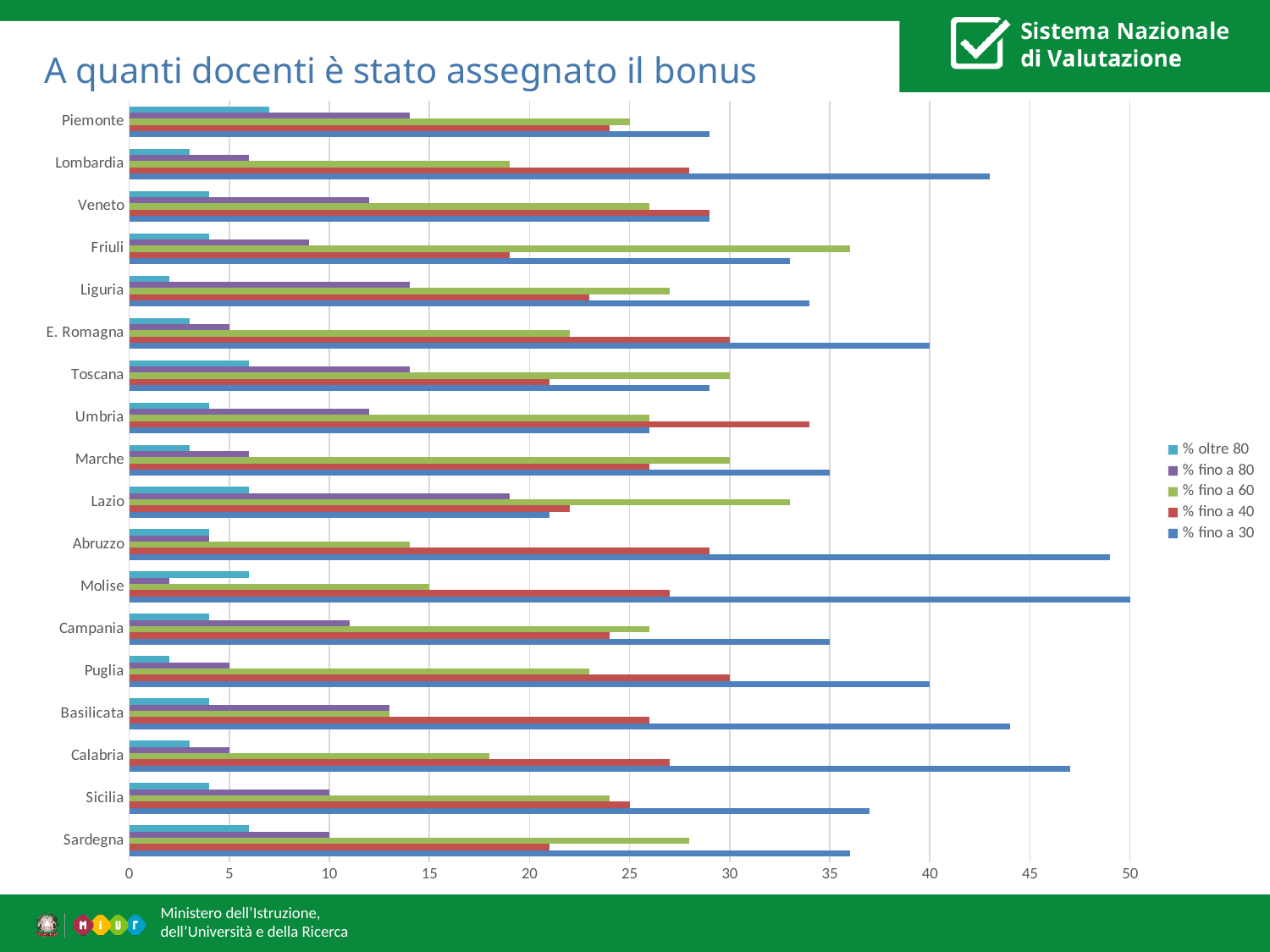
Which legend entry is shown in green? % fino a 60 How many regions are plotted on the chart? 18 Which region has the highest value for '% fino a 60'? Friuli For Umbria, which is larger: '% fino a 40' or '% fino a 30'? % fino a 40 Is the value of '% fino a 30' for Lombardia greater or less than 40? greater How many series does the legend list? 5 Is the value of '% fino a 40' for Umbria greater or less than 30? greater Is the value of '% fino a 30' for Lazio greater or less than 25? less For Friuli, which is larger: '% fino a 60' or '% fino a 30'? % fino a 60 What kind of chart is shown on the slide? bar chart